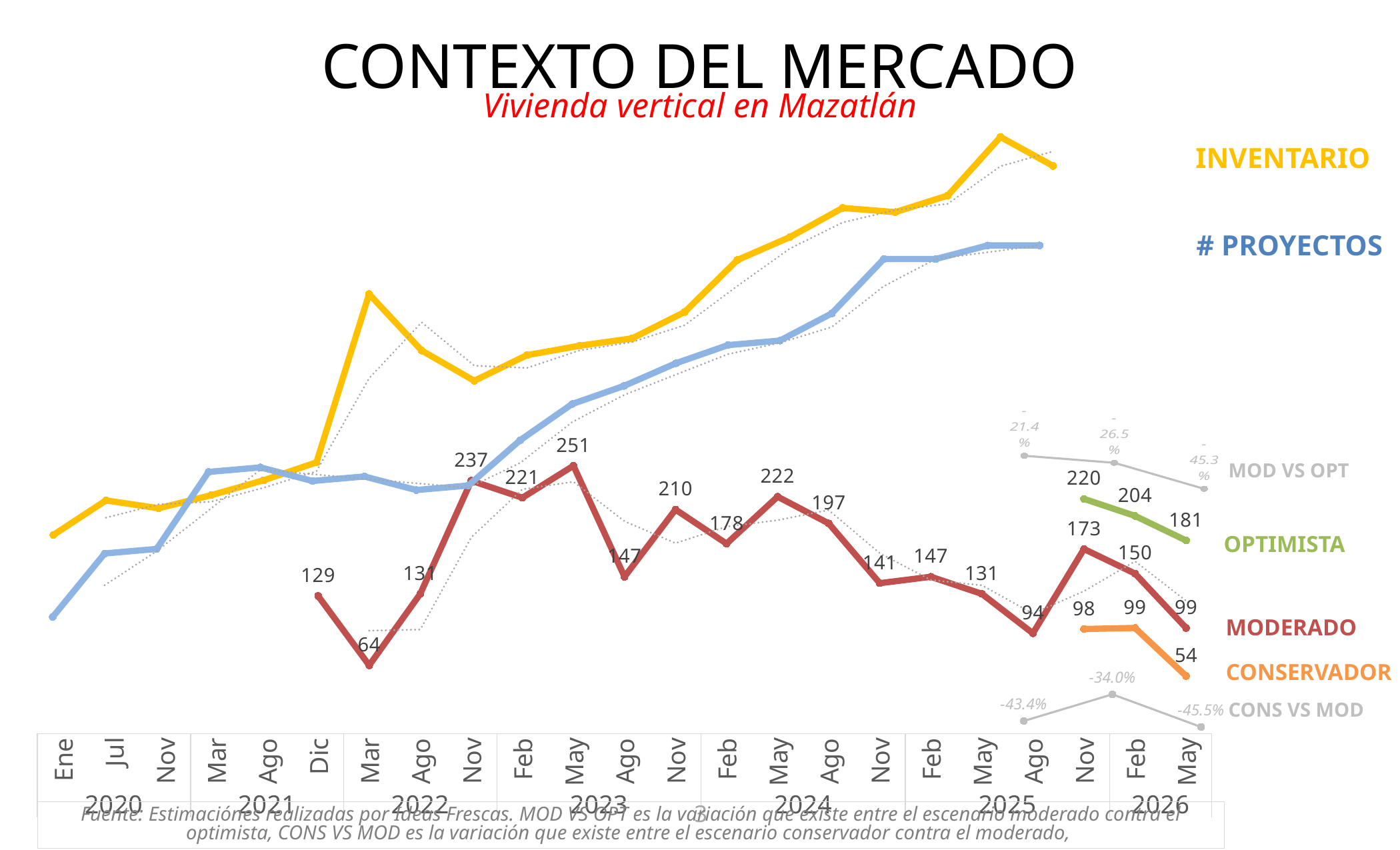
Does the OPTIMISTA series rise or fall from Nov 2025 to May 2026? fall What is the value of the MODERADO series in May 2023? 251 What is the value of the OPTIMISTA series in May 2026? 181 What is the difference between the OPTIMISTA and MODERADO values in Nov 2025? 47 What is the difference between the MODERADO and CONSERVADOR values in Feb 2026? 51 What is the value of the CONSERVADOR series in May 2026? 54 What is the MOD VS OPT value shown for May 2026? -45.3% What kind of chart is shown on the slide? line chart In which month and year does the MODERADO series reach its highest labelled value? May 2023 In which month and year does the MODERADO series reach its lowest labelled value? Mar 2022 What is the subtitle shown in red below the chart title? Vivienda vertical en Mazatlán Which is larger for the MODERADO series: the value in Nov 2022 or the value in Feb 2023? Nov 2022